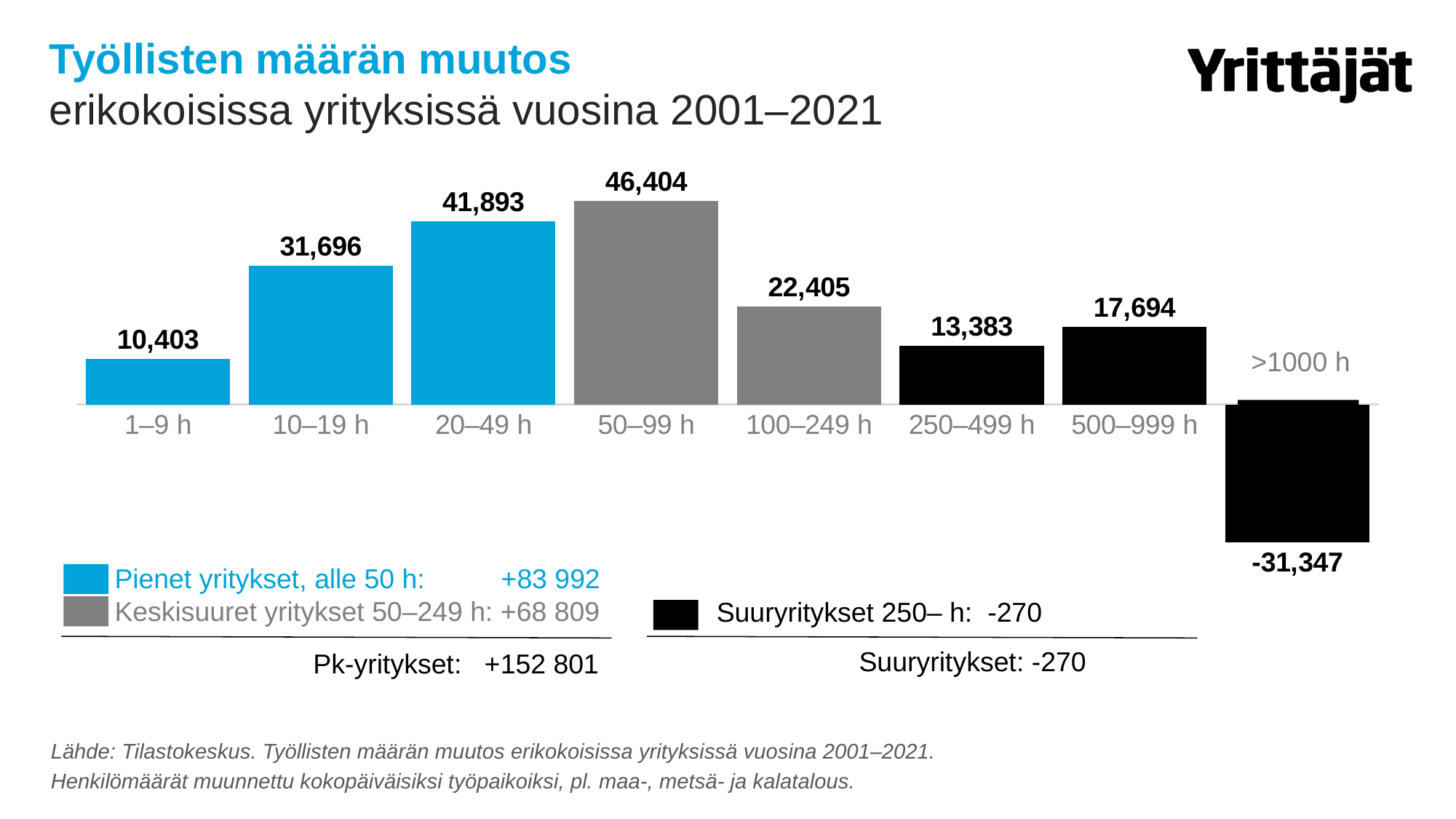
What total is given for Pk-yritykset in the legend area? +152 801 How many categories are shown on the x axis? 8 How many entries does the legend list? 3 What colour are the bars for the 50–99 h and 100–249 h categories? grey What kind of chart is shown on the slide? bar chart What is the value for the >1000 h category? -31,347 Which category has the highest value? 50–99 h Which is larger, the value for 500–999 h or the value for 250–499 h? 500–999 h Which category has the lowest value? >1000 h What is the value for the 1–9 h category? 10,403 What is the value for the 50–99 h category? 46,404 What is the difference between the values for 20–49 h and 10–19 h? 10,197